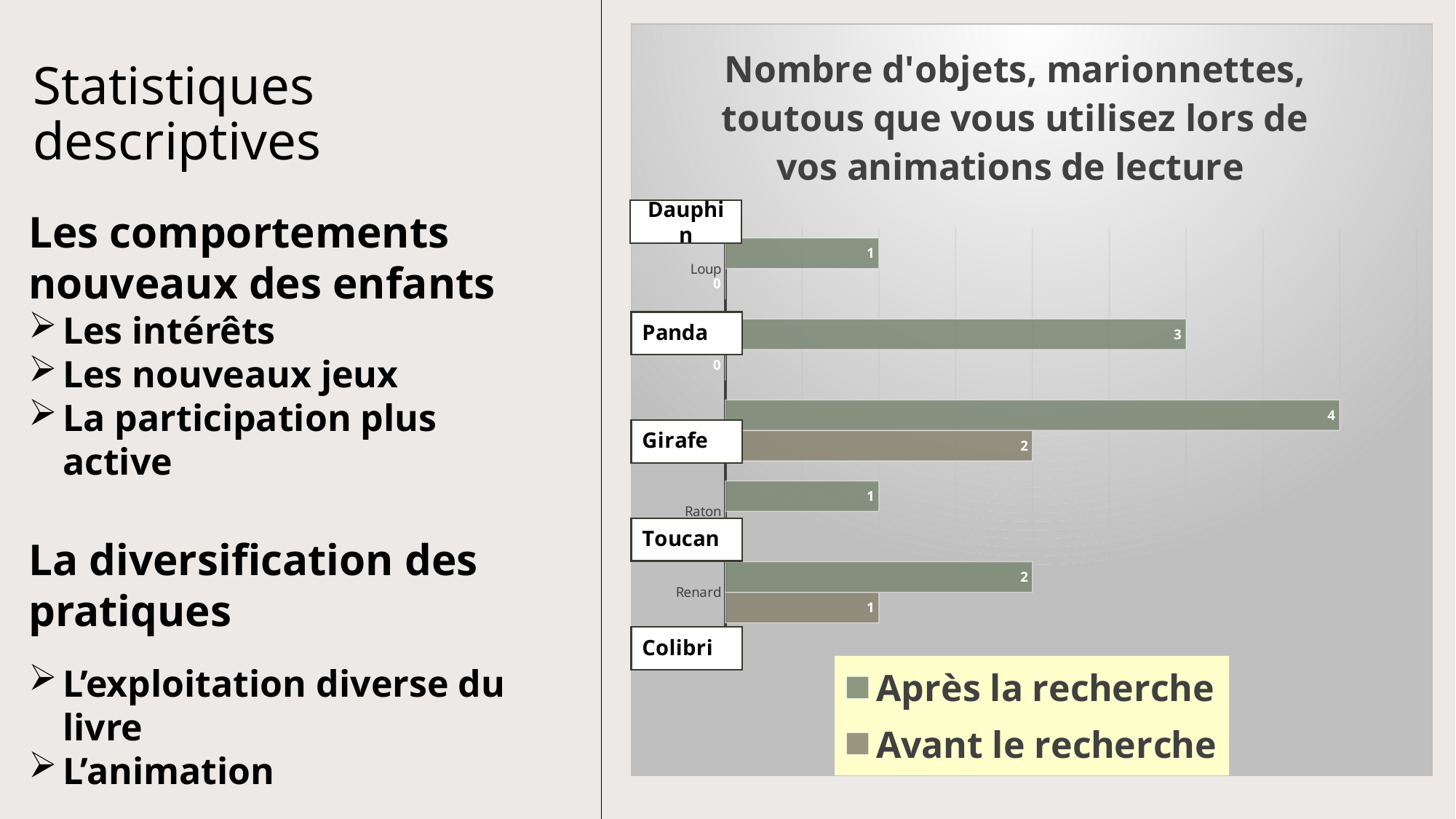
What is the highest value shown on any bar in the chart? 4 What is the value for Loup in the 'Avant le recherche' series? 0 What is the value for Renard in the 'Avant le recherche' series? 1 What is the difference between the 'Après la recherche' and 'Avant le recherche' values for Girafe? 2 What is the value for Girafe in the 'Avant le recherche' series? 2 What is the value for Renard in the 'Après la recherche' series? 2 How many series does the legend list? 2 For Renard, which series has the larger value, 'Après la recherche' or 'Avant le recherche'? Après la recherche Which category has the highest 'Après la recherche' value? Girafe What kind of chart is shown on the slide? bar chart What are the two legend entries of the chart? Après la recherche, Avant le recherche What is the value for Girafe in the 'Après la recherche' series? 4